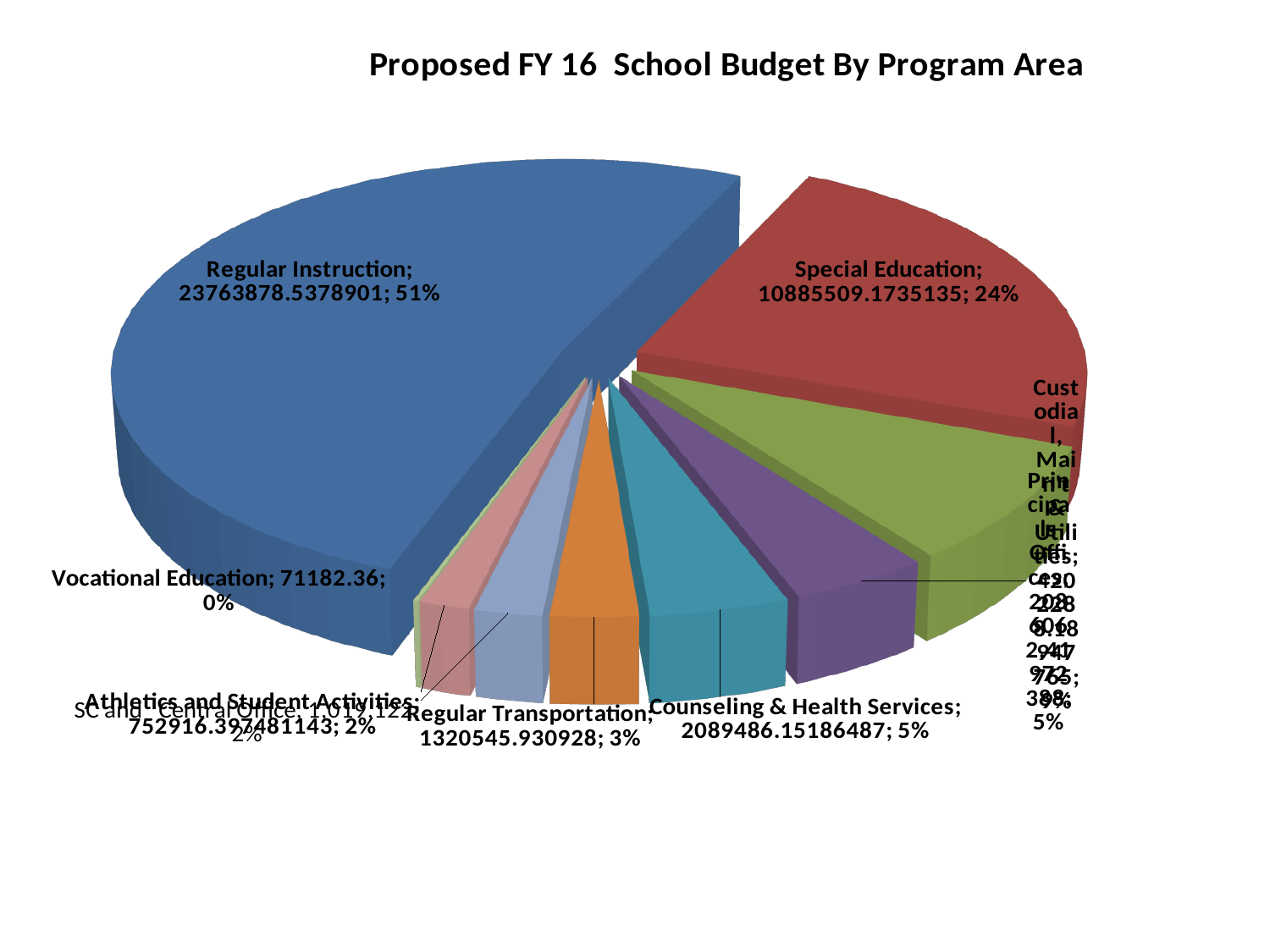
By how many percentage points does the Regular Instruction share exceed the Special Education share? 27 Which is larger, the share for Special Education or the share for Counseling & Health Services? Special Education What is the title of the chart? Proposed FY 16 School Budget By Program Area What share of the budget does Special Education represent? 24% What share of the budget does Athletics and Student Activities represent? 2% Which program area has the largest slice of the pie? Regular Instruction What kind of chart is shown on the slide? pie chart What is the value shown for Regular Transportation? 1320545.930928 What is the value shown for Counseling & Health Services? 2089486.15186487 Which program area has the smallest slice of the pie? Vocational Education What is the value shown for Vocational Education? 71182.36 What share of the budget does Regular Instruction represent? 51%